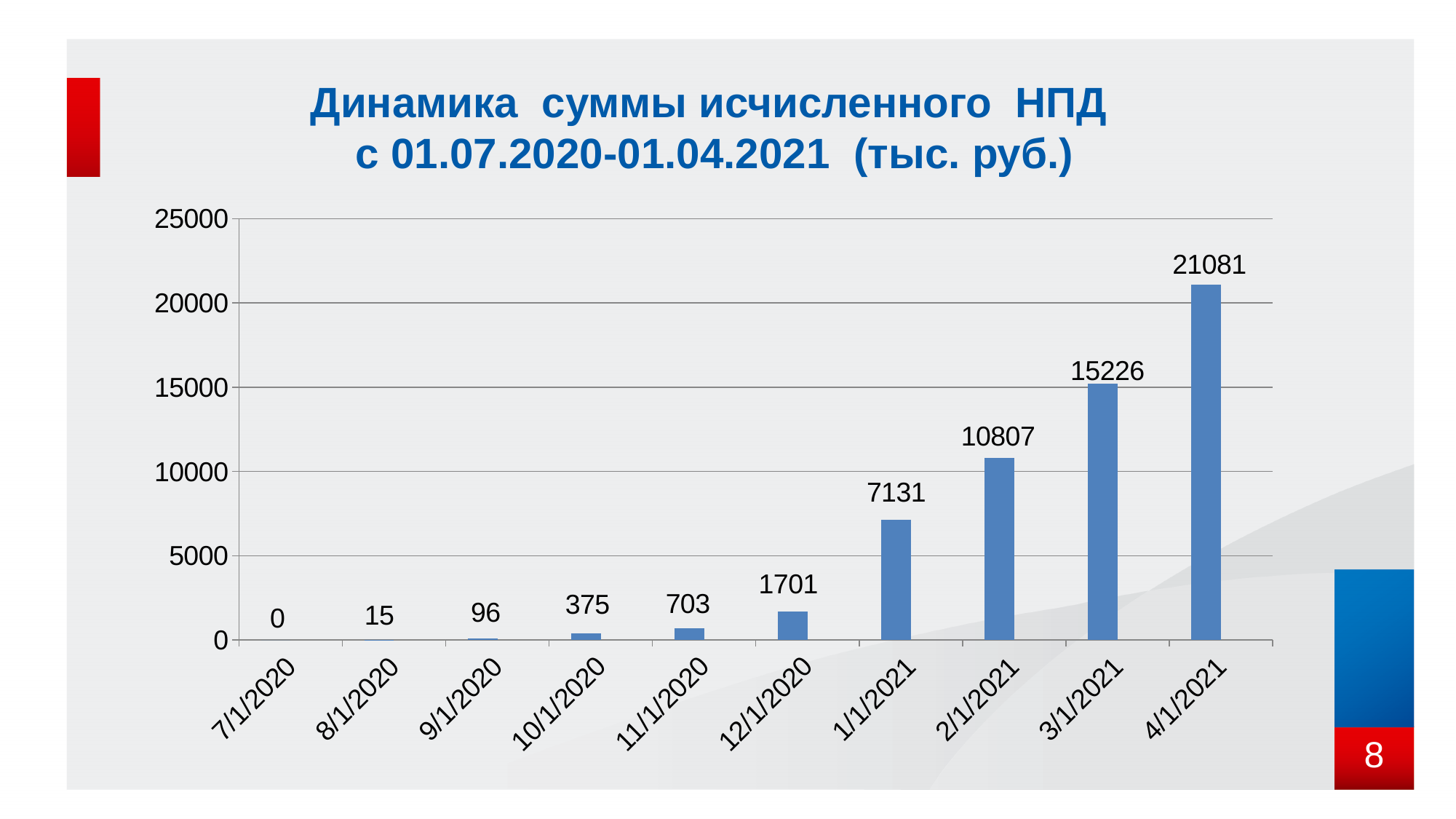
What is the difference between the values for 2/1/2021 and 1/1/2021? 3676 What kind of chart is shown on the slide? bar chart What is the value for 12/1/2020? 1701 What is the value for 4/1/2021? 21081 Which date has the lowest value? 7/1/2020 How many dates are shown on the x axis? 10 Which date has the highest value? 4/1/2021 Is the value for 3/1/2021 greater or less than 15000? greater Do the values rise or fall from 7/1/2020 to 4/1/2021? rise What is the value for 9/1/2020? 96 What is the difference between the values for 4/1/2021 and 3/1/2021? 5855 Which is larger, the value for 11/1/2020 or the value for 10/1/2020? 11/1/2020